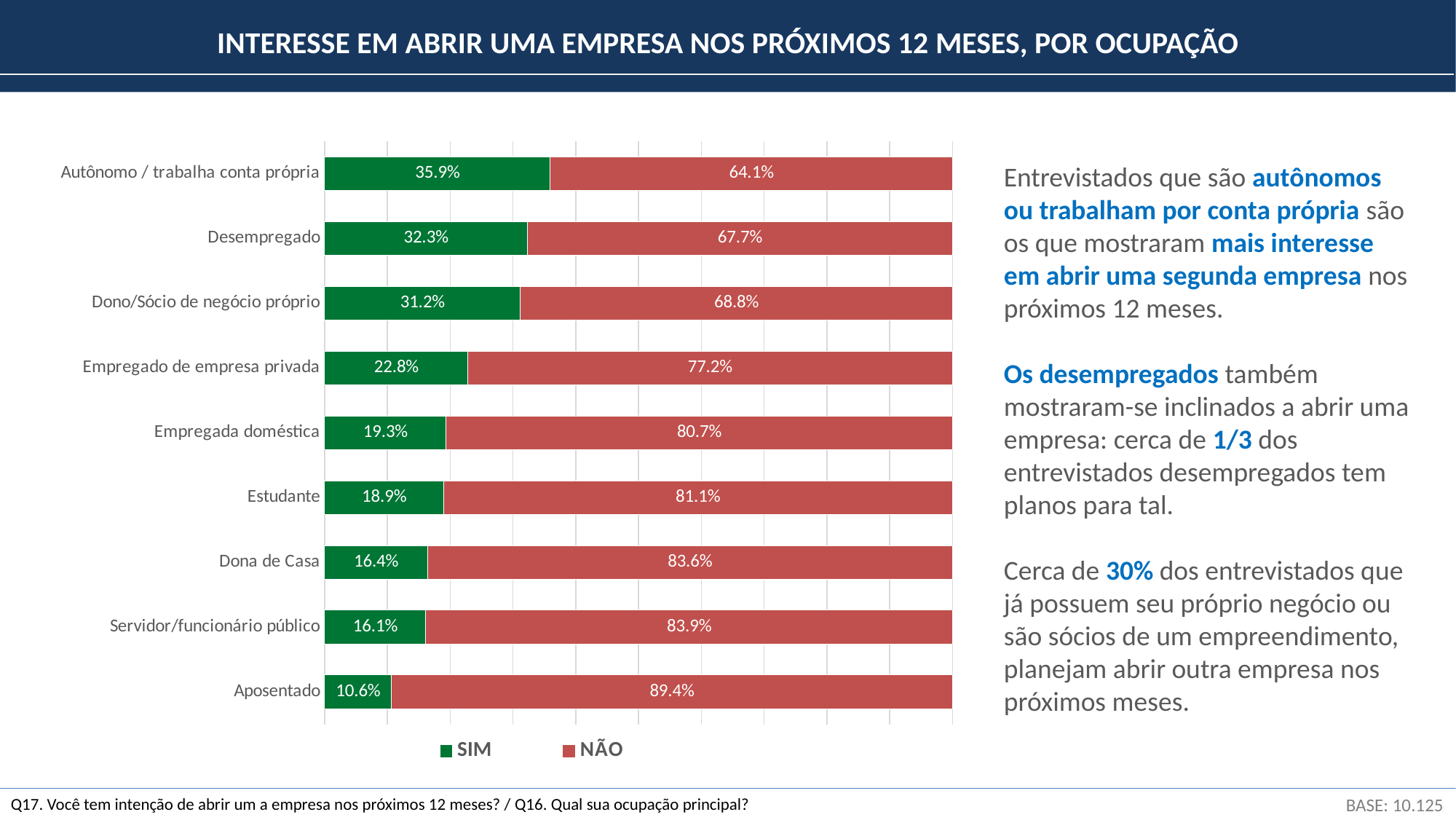
Which has a larger NÃO value, Empregada doméstica or Empregado de empresa privada? Empregada doméstica What is the SIM value for Autônomo / trabalha conta própria? 35.9% Which colour represents the SIM series in the chart? Green What is the NÃO value for Aposentado? 89.4% Which occupation has the highest SIM value? Autônomo / trabalha conta própria What kind of chart is shown on the slide? Stacked bar chart Which occupation has the lowest SIM value? Aposentado How many occupation categories are shown in the chart? 9 What is the SIM value for Estudante? 18.9% What is the total of the SIM and NÃO values for Dona de Casa? 100% How many series does the legend list? 2 What is the difference between the SIM values for Desempregado and Dono/Sócio de negócio próprio? 1.1%